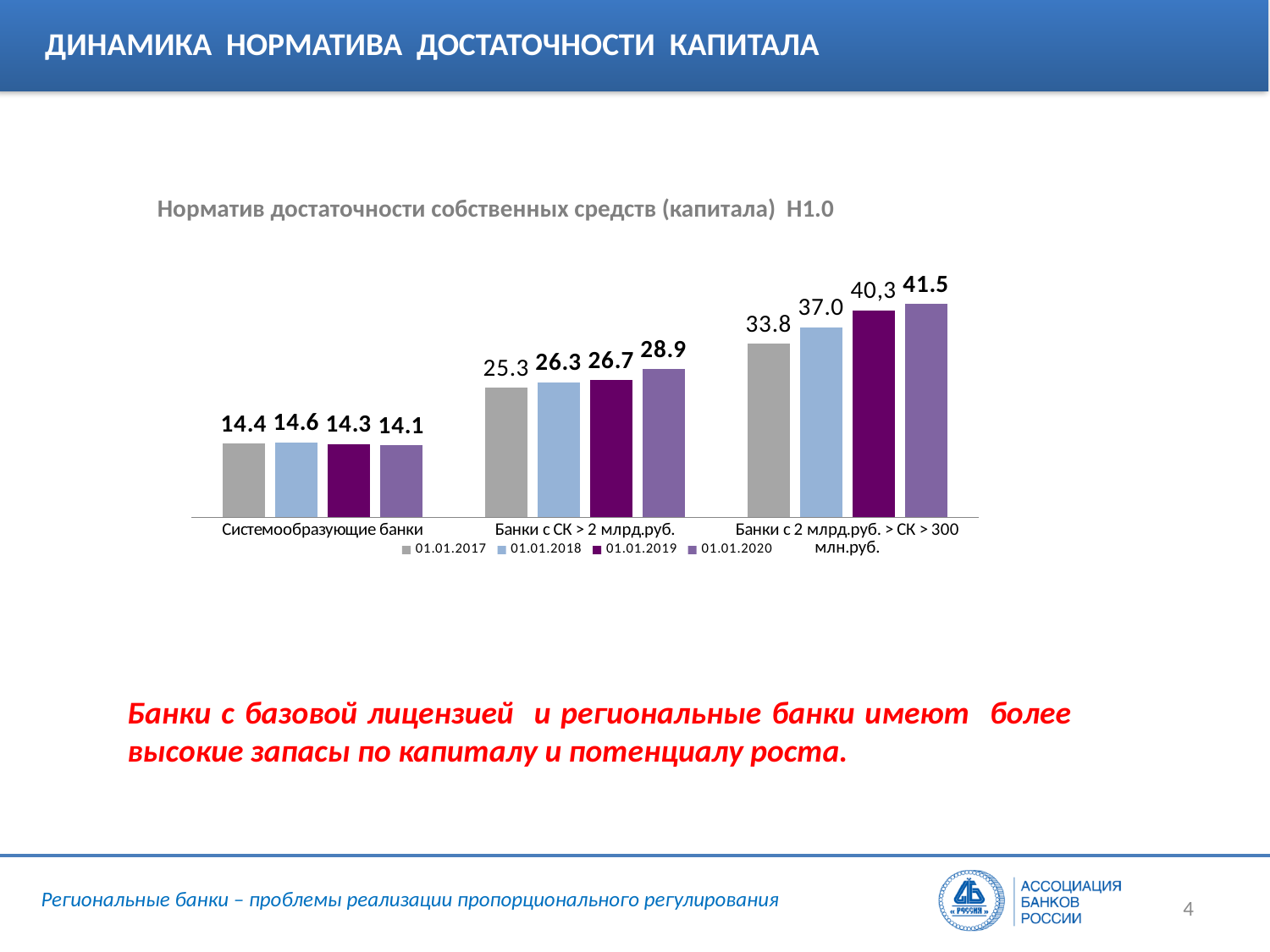
What type of chart is shown on the slide? Bar chart What is the value for Банки с 2 млрд.руб. > СК > 300 млн.руб. on 01.01.2018? 37.0 What is the value for Системообразующие банки on 01.01.2017? 14.4 What is the value for Банки с СК > 2 млрд.руб. on 01.01.2020? 28.9 Which category has the lowest value on 01.01.2017? Системообразующие банки Which is larger for Банки с СК > 2 млрд.руб.: the value on 01.01.2017 or on 01.01.2020? 01.01.2020 What is the value for Банки с 2 млрд.руб. > СК > 300 млн.руб. on 01.01.2019? 40,3 How many categories are shown on the x axis? 3 What is the difference between the 01.01.2020 and 01.01.2017 values for Банки с 2 млрд.руб. > СК > 300 млн.руб.? 7.7 Which category has the highest value on 01.01.2020? Банки с 2 млрд.руб. > СК > 300 млн.руб. How many series does the legend list? 4 Do the values for Банки с СК > 2 млрд.руб. rise or fall from 01.01.2017 to 01.01.2020? Rise